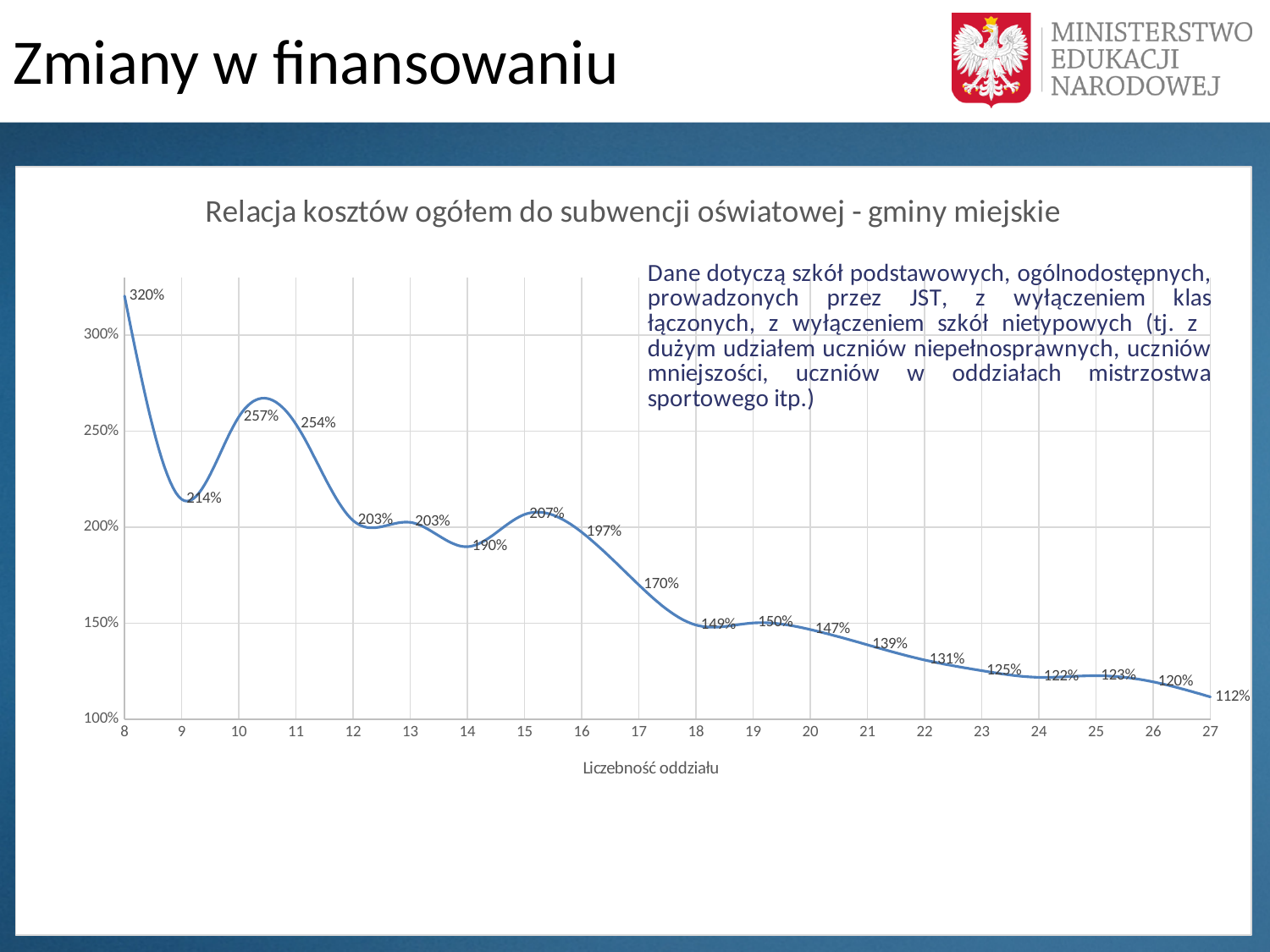
Which has the larger value: class size 10 or class size 11? 10 What is the value for a class size of 14? 190% Which class size has the highest value on the chart? 8 What is the difference between the value for class size 8 and the value for class size 27? 208 percentage points How many data points are plotted on the chart? 20 Which class size has the lowest value on the chart? 27 Is the value for class size 21 greater or less than 150%? less What is the value for a class size of 17? 170% What is the value for a class size of 27? 112% What is the value for a class size (Liczebność oddziału) of 8? 320% What kind of chart is shown on the slide? line chart Do the values generally rise or fall as class size increases from 8 to 27? fall